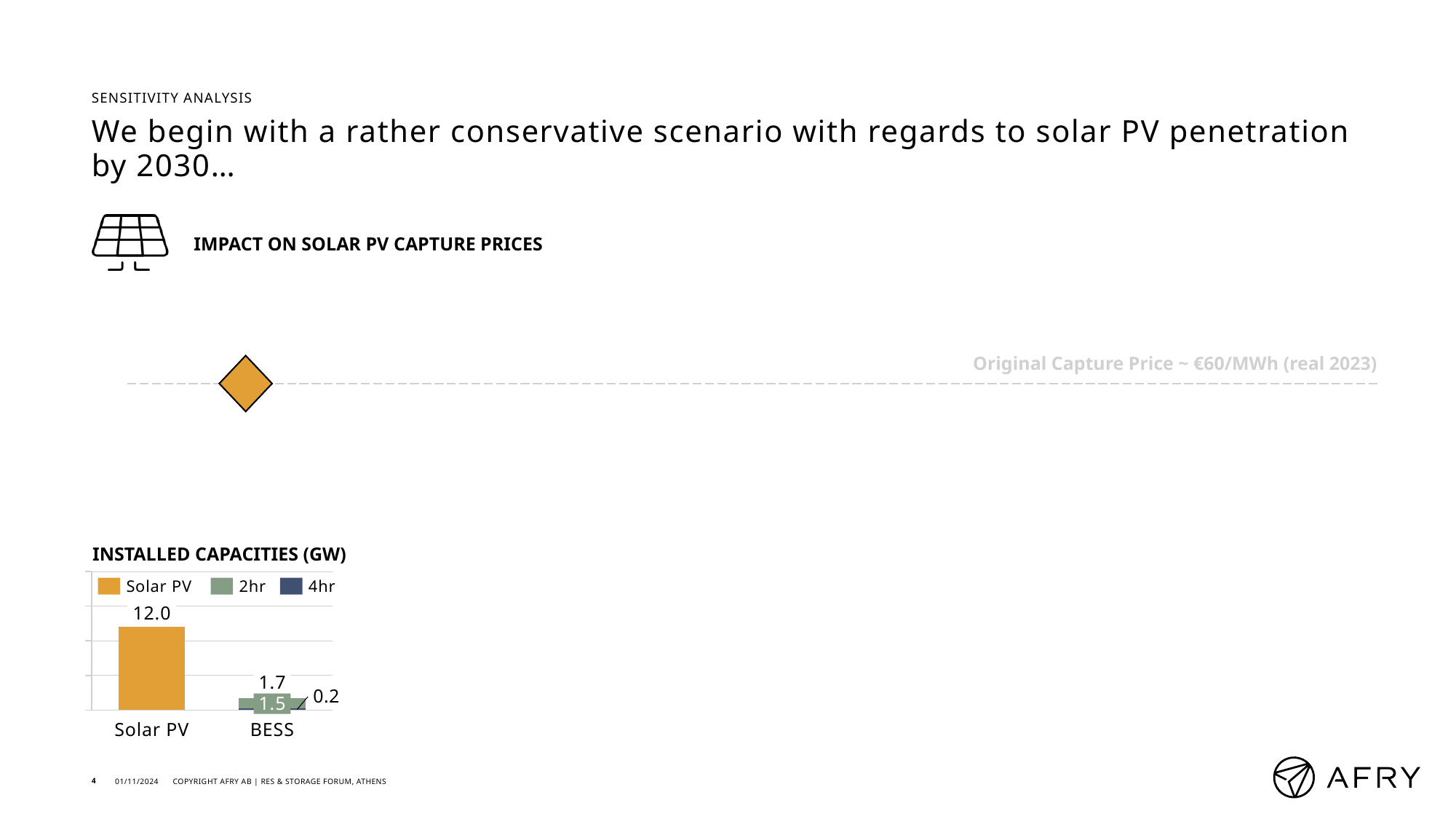
In the Installed Capacities (GW) chart, which category has the highest installed capacity? Solar PV How many series does the legend of the Installed Capacities (GW) chart list? 3 In the Installed Capacities (GW) chart, what is the 2hr value for BESS? 1.5 In the Installed Capacities (GW) chart, what is the value for Solar PV? 12.0 In the Installed Capacities (GW) chart, which category has the lowest total installed capacity? BESS In the Installed Capacities (GW) chart, which is larger: the 2hr BESS capacity or the 4hr BESS capacity? 2hr How many categories are shown on the x axis of the Installed Capacities (GW) chart? 2 What type of chart is the Installed Capacities (GW) chart? Bar chart In the Installed Capacities (GW) chart, what is the total installed capacity for BESS? 1.7 In the Installed Capacities (GW) chart, what colour is the Solar PV series? Orange In the Installed Capacities (GW) chart, what is the difference between the Solar PV capacity and the total BESS capacity? 10.3 In the Installed Capacities (GW) chart, what is the 4hr value for BESS? 0.2